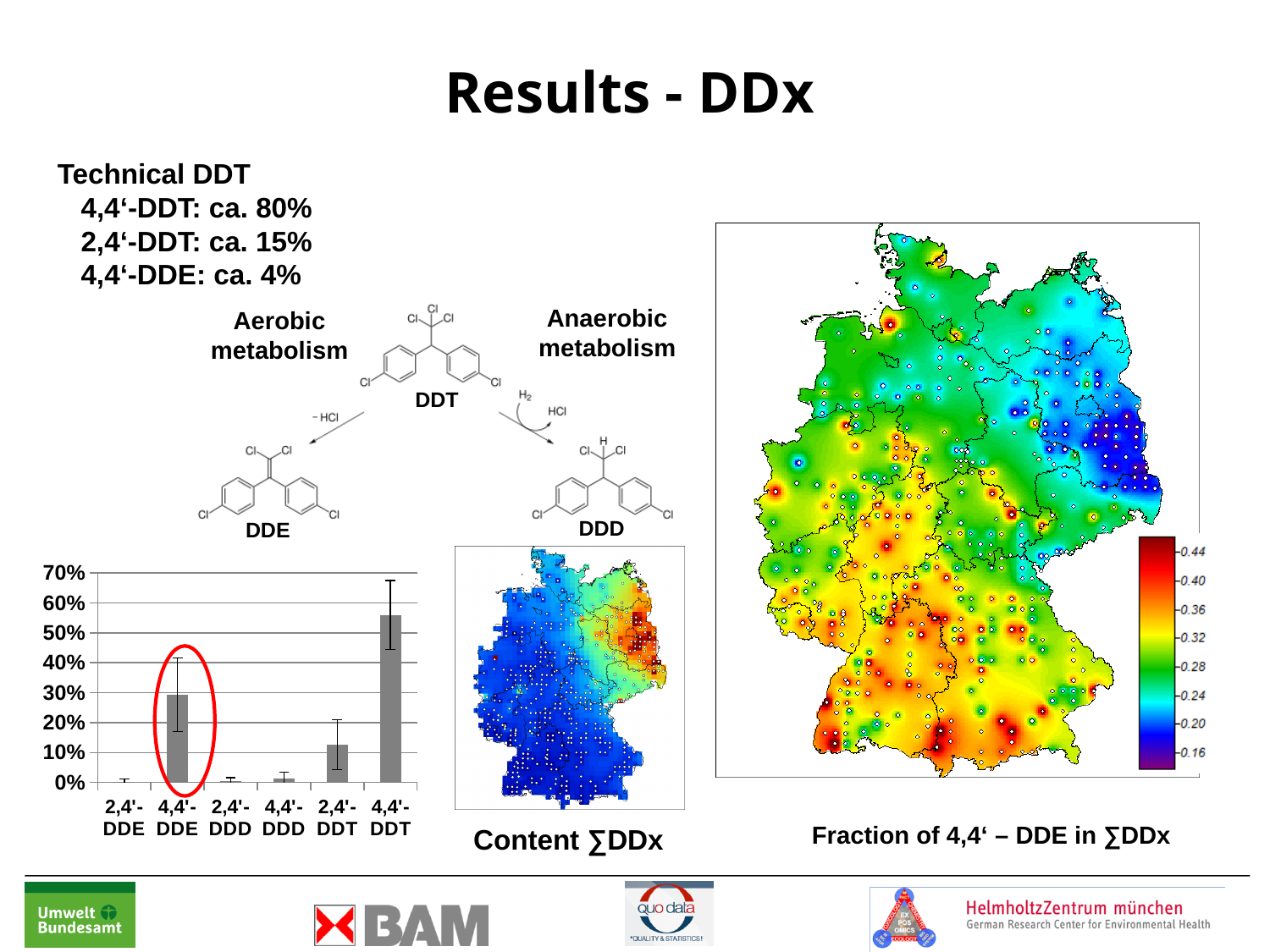
How many categories are shown on the x axis of the bar chart? 6 In the bar chart, is the value for 4,4'-DDT greater or less than 50%? greater What is the highest value shown on the y axis of the bar chart? 70% In the bar chart, which is larger: the value for 4,4'-DDE or the value for 2,4'-DDT? 4,4'-DDE In the bar chart, is the value for 4,4'-DDE greater or less than 20%? greater In the bar chart, is the value for 4,4'-DDE greater or less than 40%? less Which category has the highest bar in the bar chart? 4,4'-DDT Which bar in the bar chart is highlighted with a red circle? 4,4'-DDE What kind of chart is shown at the bottom left of the slide? bar chart In the bar chart, which is larger: the value for 4,4'-DDT or the value for 4,4'-DDE? 4,4'-DDT